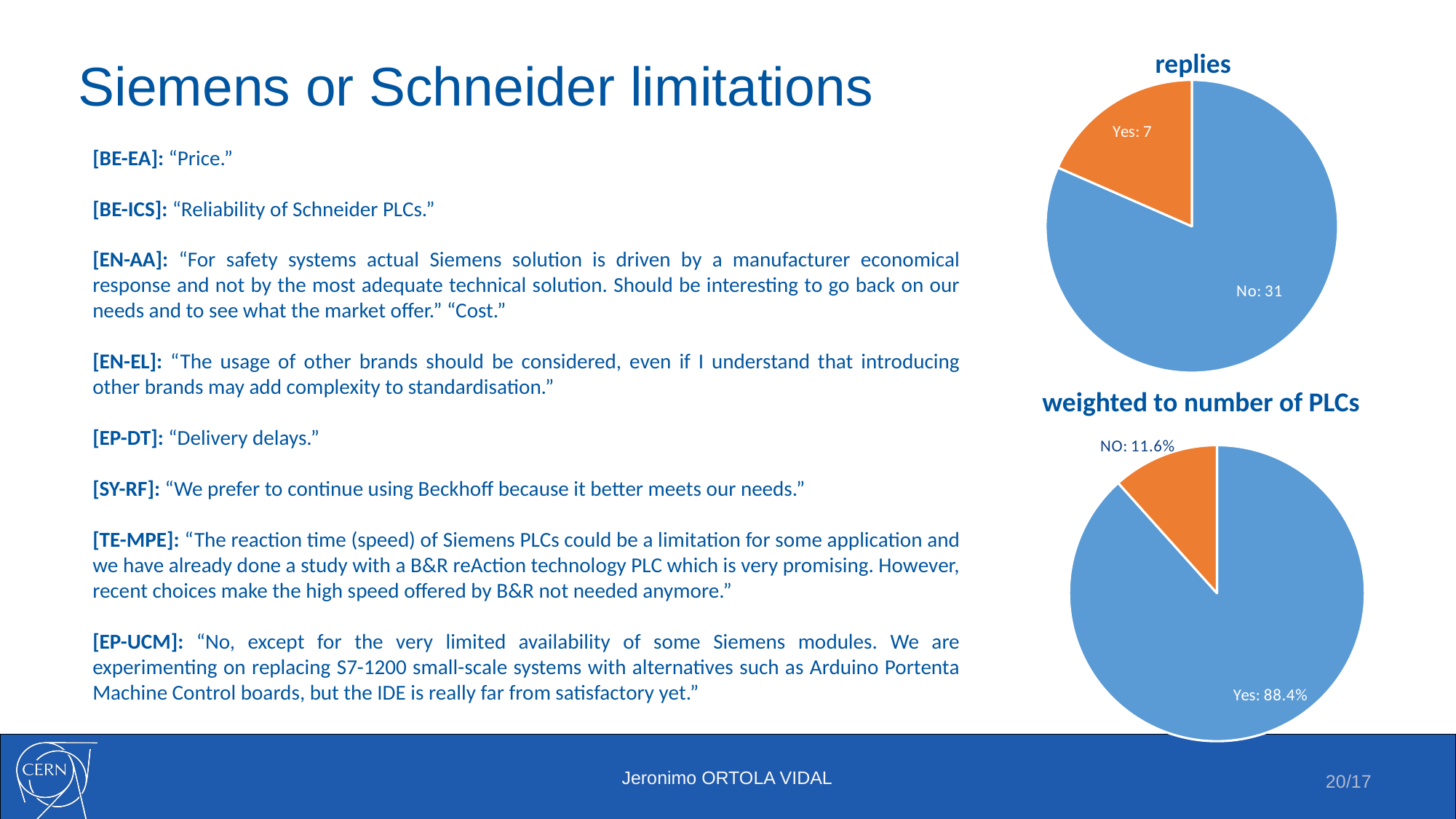
In the 'replies' pie chart, what is the difference between the number of 'No' and 'Yes' replies? 24 In the 'weighted to number of PLCs' pie chart, which slice is larger, 'Yes' or 'NO'? Yes In the 'weighted to number of PLCs' pie chart, what share is labelled 'Yes'? 88.4% In the 'weighted to number of PLCs' pie chart, what colour is the 'NO' slice? Orange In the 'replies' pie chart, how many replies were 'Yes'? 7 In the 'weighted to number of PLCs' pie chart, what share is labelled 'NO'? 11.6% In the 'replies' pie chart, which slice is the smallest? Yes In the 'replies' pie chart, how many replies were 'No'? 31 In the 'replies' pie chart, how many slices are there? 2 In the 'replies' pie chart, which slice is the largest? No What type of chart is the 'replies' chart? Pie chart In the 'replies' pie chart, what is the total number of replies shown? 38